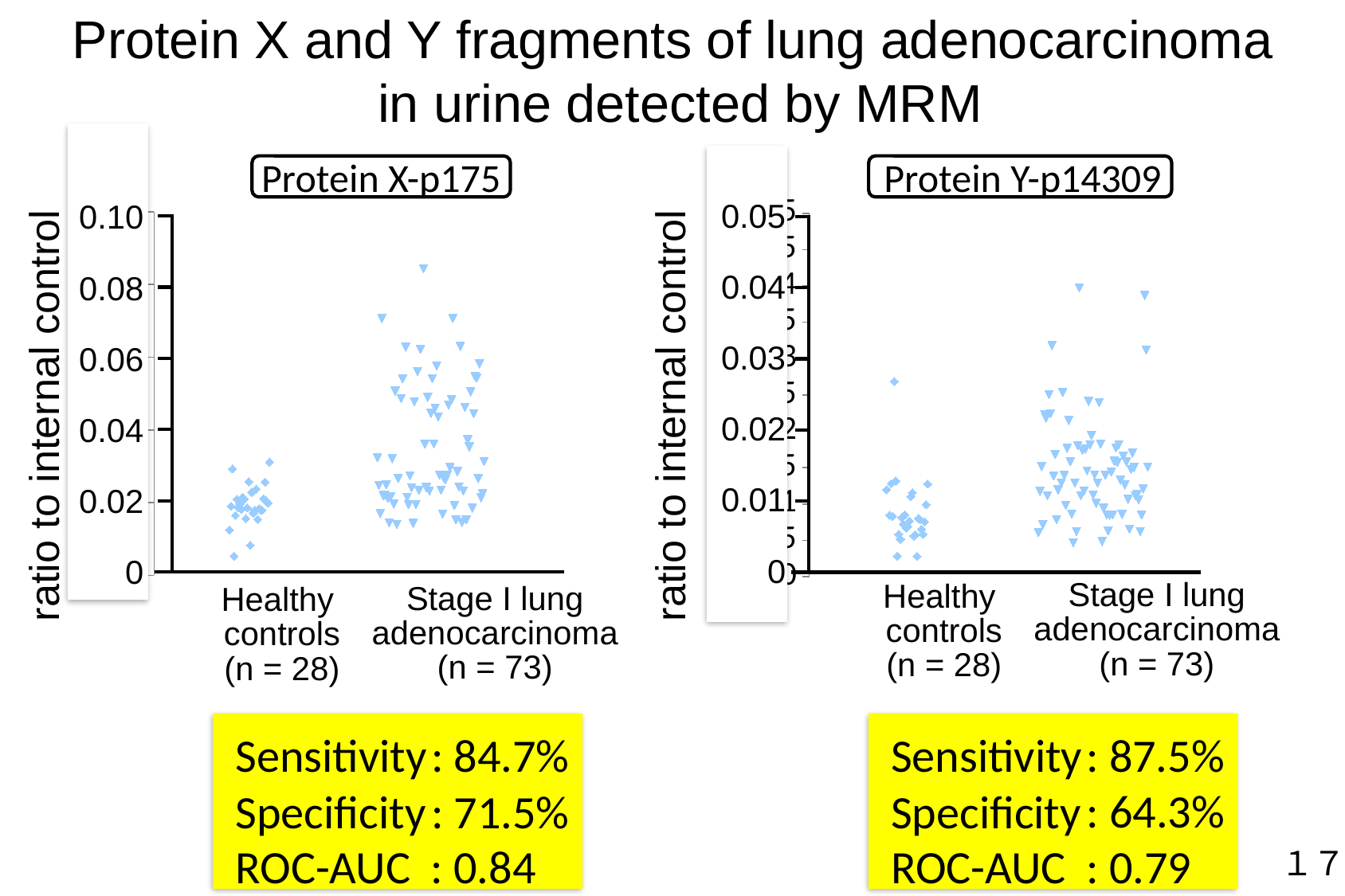
What is the y-axis label of the Protein X-p175 chart? ratio to internal control In the Protein Y-p14309 chart, is the highest value for Stage I lung adenocarcinoma greater or less than 0.03? greater In the Protein Y-p14309 chart, which group has more plotted points, Healthy controls or Stage I lung adenocarcinoma? Stage I lung adenocarcinoma In the Protein X-p175 chart, how many healthy controls are there according to the x-axis label? 28 How many groups are shown on the x axis of the Protein X-p175 chart? 2 In the Protein X-p175 chart, is the highest value for Stage I lung adenocarcinoma greater or less than 0.08? greater In the Protein Y-p14309 chart, is the highest value for Healthy controls greater or less than 0.04? less What is the title of the chart on the right side of the slide? Protein Y-p14309 In the Protein X-p175 chart, which group has the higher maximum value, Healthy controls or Stage I lung adenocarcinoma? Stage I lung adenocarcinoma What kind of chart is the Protein X-p175 chart? scatter plot In the Protein Y-p14309 chart, how many Stage I lung adenocarcinoma samples are there according to the x-axis label? 73